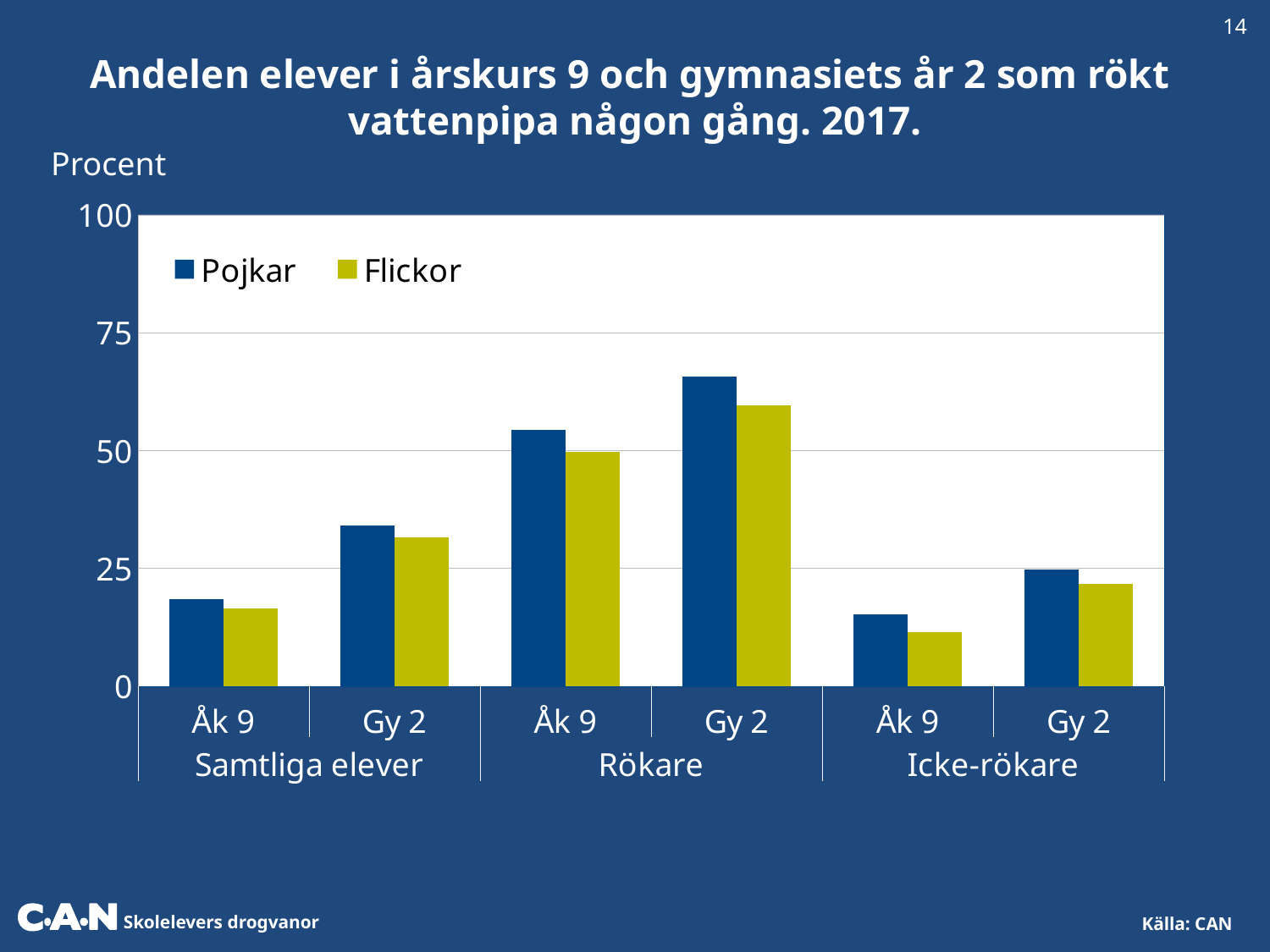
Which category has the lowest Flickor bar? Åk 9, Icke-rökare What unit label is shown above the y axis? Procent For Gy 2 among Rökare, which is larger: Pojkar or Flickor? Pojkar Which series is shown in yellow-green in the legend? Flickor What kind of chart is shown on the slide? Bar chart How many series does the legend list? 2 Is the Flickor value for Åk 9 among Samtliga elever greater or less than 25? less How many category groups (Åk 9 / Gy 2 pairs) are shown along the x axis? 3 Is the Pojkar value for Gy 2 among Samtliga elever greater or less than 25? greater Is the Pojkar value for Gy 2 among Rökare greater or less than 50? greater Which Pojkar bar is larger: Åk 9 among Rökare or Gy 2 among Samtliga elever? Åk 9 among Rökare Which category has the highest Pojkar bar? Gy 2, Rökare